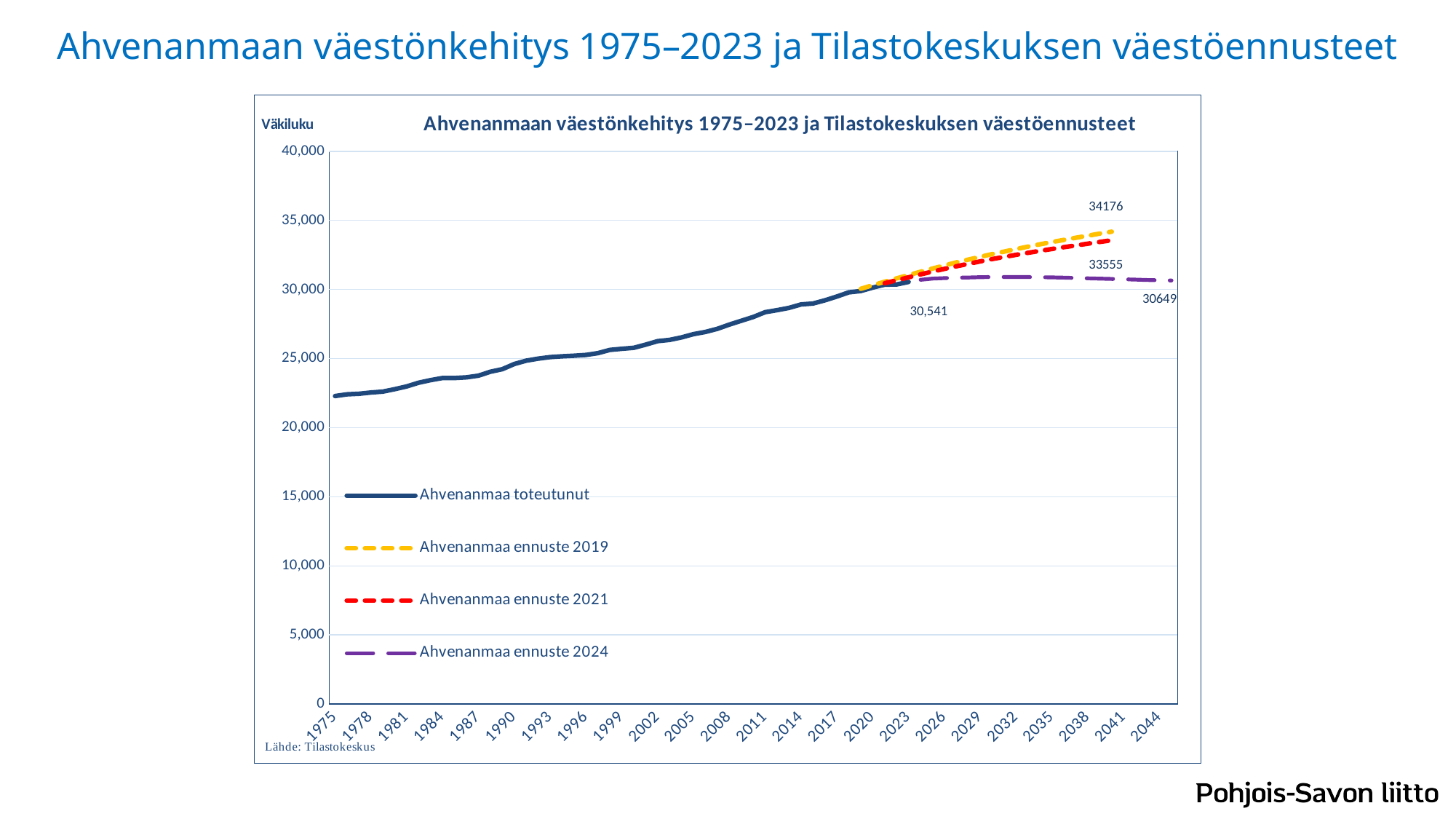
What is the labelled end value of the Ahvenanmaa ennuste 2019 line? 34176 Which forecast line ends at the highest labelled value? Ahvenanmaa ennuste 2019 What is the labelled end value of the Ahvenanmaa ennuste 2024 line? 30649 What type of chart is shown on the slide? line chart What is the difference between the labelled end values of the ennuste 2019 and ennuste 2021 lines? 621 What is the difference between the labelled end values of the ennuste 2019 and ennuste 2024 lines? 3527 Is the value of the Ahvenanmaa toteutunut line in 1975 greater or less than 25,000? less How many series does the legend list? 4 Which ends higher: the ennuste 2021 line or the ennuste 2024 line? Ahvenanmaa ennuste 2021 What is the labelled value at the end of the Ahvenanmaa toteutunut line (2023)? 30,541 What is the labelled end value of the Ahvenanmaa ennuste 2021 line? 33555 Does the Ahvenanmaa toteutunut line rise or fall from 1975 to 2023? rise